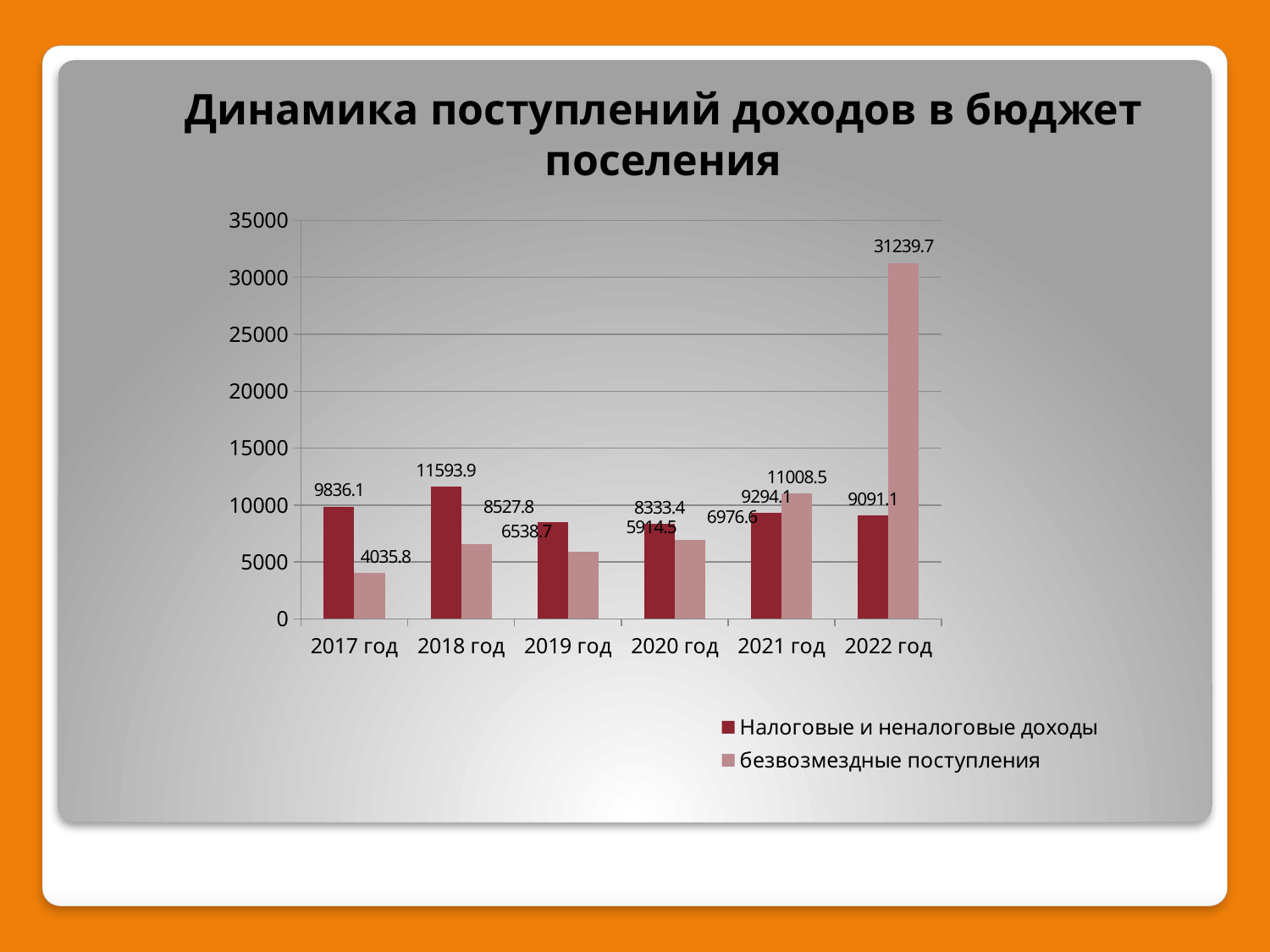
What type of chart is shown on the slide? bar chart How many years are shown on the x axis? 6 In 2021 год, which series has the larger value: Налоговые и неналоговые доходы or безвозмездные поступления? безвозмездные поступления What is the difference between безвозмездные поступления and Налоговые и неналоговые доходы in 2022 год? 22148.6 What is the difference between Налоговые и неналоговые доходы and безвозмездные поступления in 2017 год? 5800.3 What is the value of безвозмездные поступления for 2022 год? 31239.7 What is the value of Налоговые и неналоговые доходы for 2018 год? 11593.9 How many series does the legend list? 2 In which year is Налоговые и неналоговые доходы the highest? 2018 год In which year is безвозмездные поступления the highest? 2022 год In which year is безвозмездные поступления the lowest? 2017 год What is the value of безвозмездные поступления for 2020 год? 6976.6